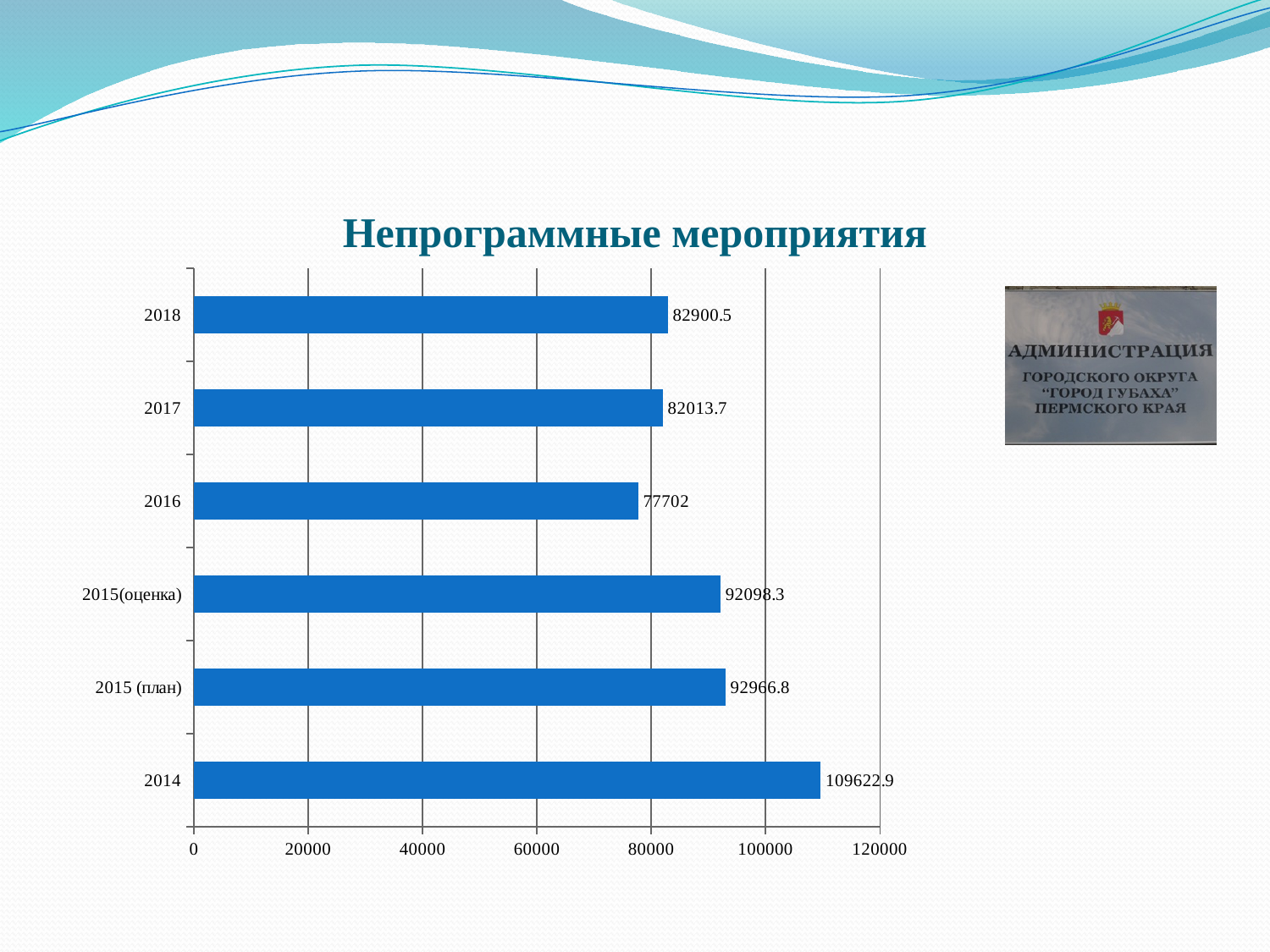
What is the value for 2018? 82900.5 Is the value for 2016 greater or less than 80000? less Which category has the lowest value? 2016 What is the title of the chart? Непрограммные мероприятия What is the value for 2015 (план)? 92966.8 What is the value for 2015(оценка)? 92098.3 What is the value for 2016? 77702 Which category has the highest value? 2014 Which is larger, the value for 2014 or the value for 2017? 2014 How many bars are shown in the chart? 6 What kind of chart is shown on the slide? bar chart What is the difference between the values for 2014 and 2016? 31920.9